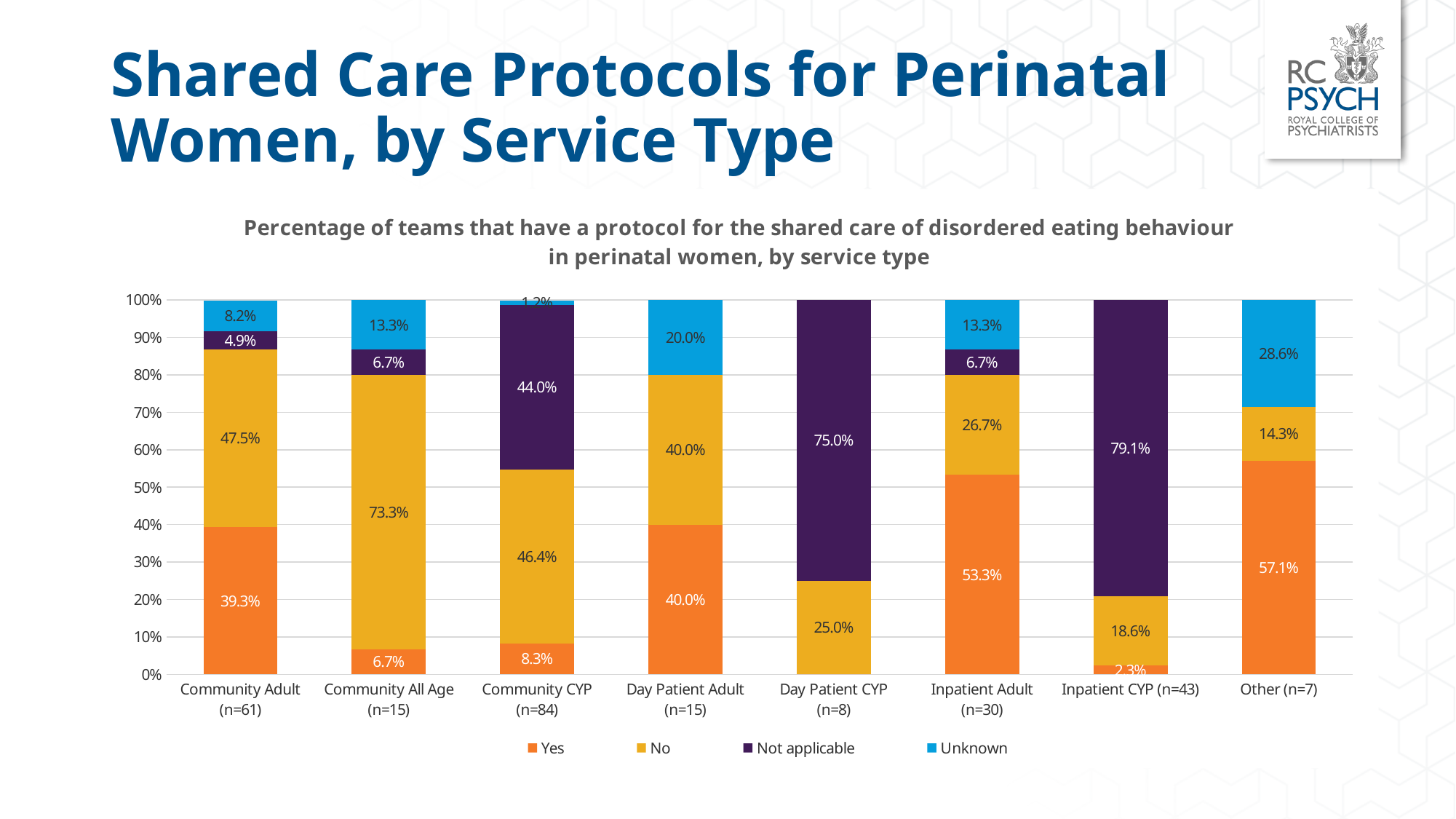
What percentage of Community Adult (n=61) teams answered Yes? 39.3% What is the difference between the Yes percentages for Inpatient Adult (n=30) and Community Adult (n=61)? 14.0% What is the Unknown percentage for Other (n=7)? 28.6% What is the Not applicable percentage for Inpatient CYP (n=43)? 79.1% Which service type has the highest Yes percentage? Other (n=7) Which is larger: the Not applicable percentage for Day Patient CYP (n=8) or for Community CYP (n=84)? Day Patient CYP (n=8) How many series does the legend list? 4 What is the No percentage for Community All Age (n=15)? 73.3% How many service types are shown on the x axis? 8 What kind of chart is shown on the slide? Stacked bar chart Which colour represents the Not applicable series in the legend? Dark purple Which service type has the lowest No percentage? Other (n=7)